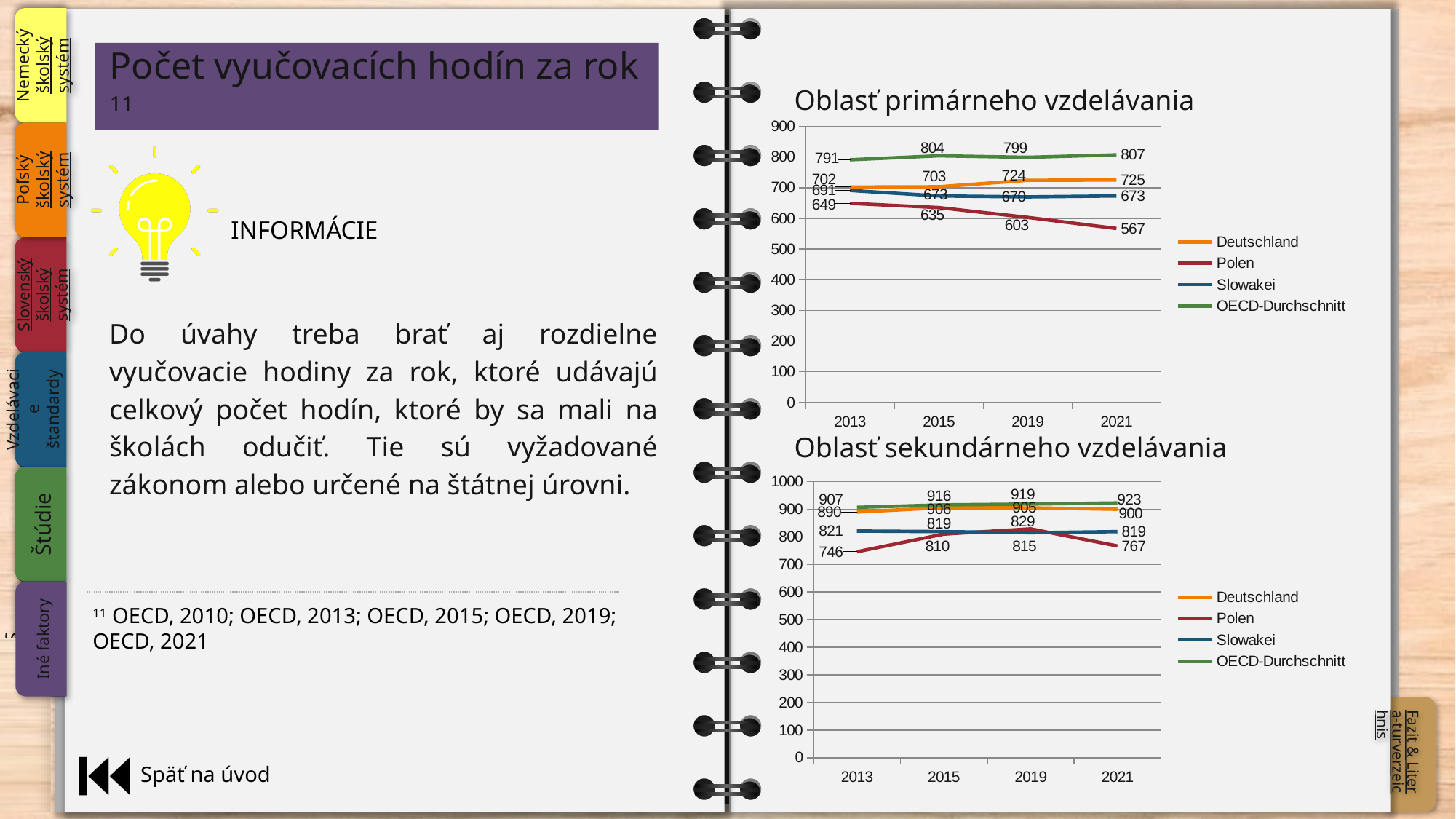
In the chart 'Oblasť primárneho vzdelávania', what is the difference between Deutschland and Slowakei in 2019? 54 In the chart 'Oblasť primárneho vzdelávania', which series has the lowest value in 2021? Polen In the chart 'Oblasť primárneho vzdelávania', how many series does the legend list? 4 In the chart 'Oblasť sekundárneho vzdelávania', what is the value for Polen in 2019? 829 In the chart 'Oblasť primárneho vzdelávania', does the value for Polen rise or fall from 2013 to 2021? fall In the chart 'Oblasť primárneho vzdelávania', what is the value for Polen in 2021? 567 In the chart 'Oblasť sekundárneho vzdelávania', what is the value for Deutschland in 2013? 890 In the chart 'Oblasť sekundárneho vzdelávania', how many years are shown on the x axis? 4 In the chart 'Oblasť sekundárneho vzdelávania', which is larger in 2019: Polen or Slowakei? Polen In the chart 'Oblasť sekundárneho vzdelávania', which series has the highest value in 2021? OECD-Durchschnitt What type of chart is 'Oblasť sekundárneho vzdelávania'? line chart In the chart 'Oblasť primárneho vzdelávania', what is the value for OECD-Durchschnitt in 2015? 804